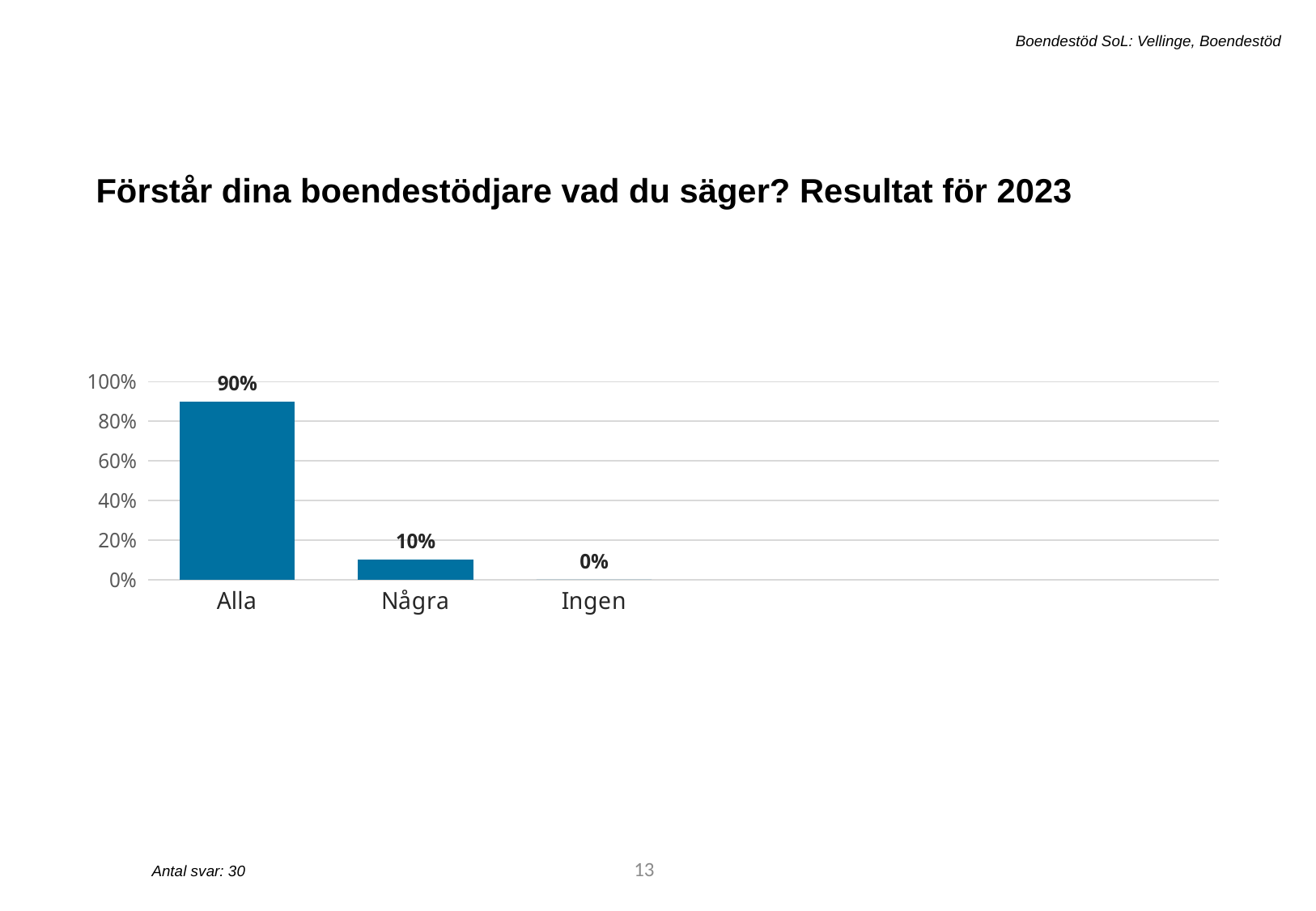
Which is larger, the value for Några or the value for Ingen? Några What is the value for Ingen? 0% Do the values rise or fall from left to right along the x axis? fall What is the value for Alla? 90% Which category has the highest value? Alla How many categories are shown on the x axis? 3 What kind of chart is shown on the slide? bar chart What is the title of the chart? Förstår dina boendestödjare vad du säger? Resultat för 2023 What is the difference between the values for Alla and Några? 80% Which category has the lowest value? Ingen Is the value for Alla greater or less than 80%? greater What is the value for Några? 10%